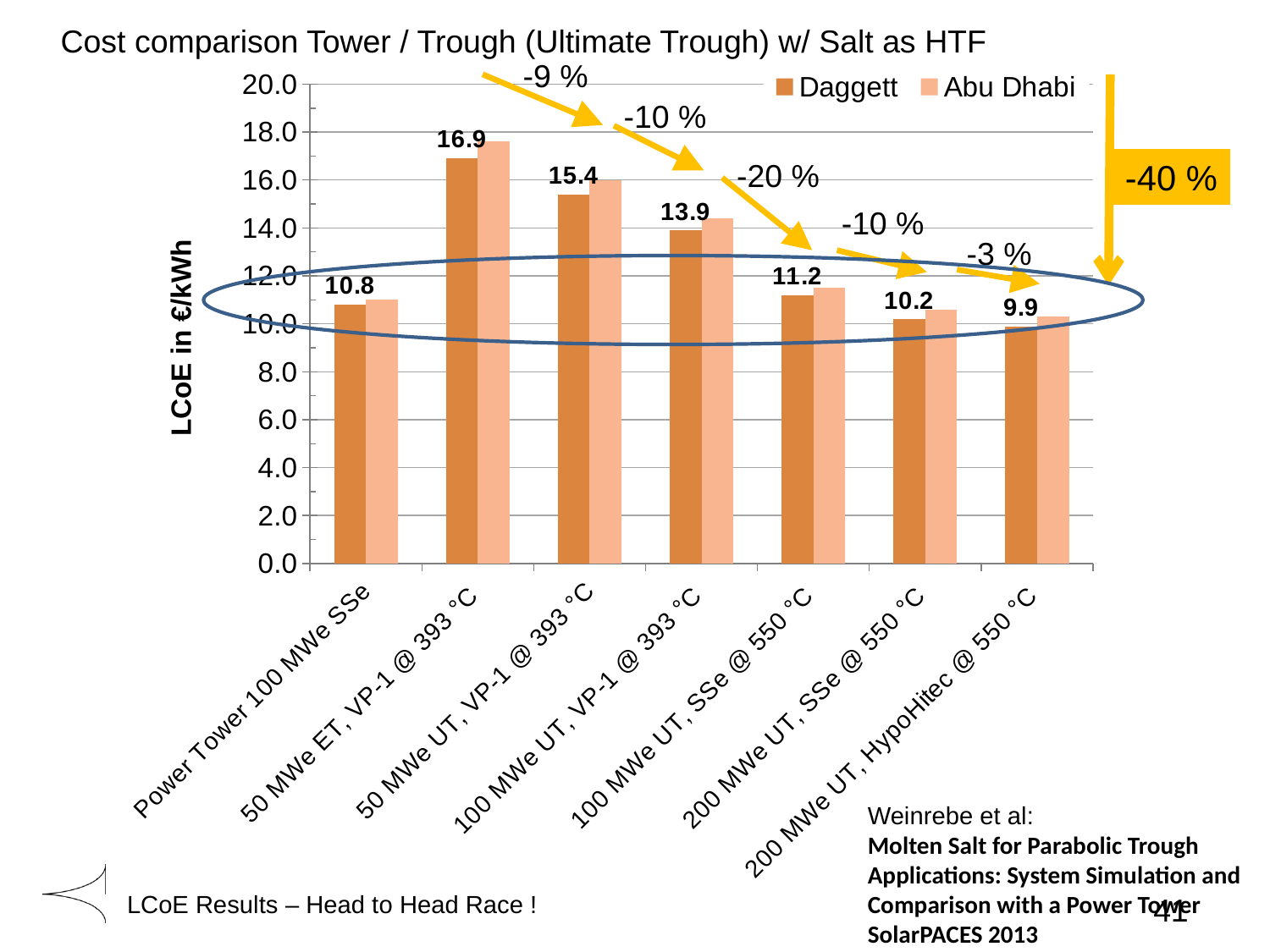
How many series does the legend list? 2 What is the Daggett LCoE value for the Power Tower 100 MWe SSe configuration? 10.8 What is the Daggett LCoE value for the 50 MWe ET, VP-1 @ 393 °C configuration? 16.9 Is the Abu Dhabi LCoE for 50 MWe ET, VP-1 @ 393 °C greater or less than 16.0? greater Is the Abu Dhabi LCoE for Power Tower 100 MWe SSe greater or less than 12.0? less What is the label of the vertical axis? LCoE in €/kWh Which has the larger Daggett LCoE: 50 MWe UT, VP-1 @ 393 °C or 100 MWe UT, SSe @ 550 °C? 50 MWe UT, VP-1 @ 393 °C What is the Daggett LCoE value for the 200 MWe UT, HypoHitec @ 550 °C configuration? 9.9 How many plant configurations are shown on the x axis? 7 Which configuration has the lowest Daggett LCoE? 200 MWe UT, HypoHitec @ 550 °C Which configuration has the highest Daggett LCoE? 50 MWe ET, VP-1 @ 393 °C What is the difference between the Daggett LCoE for 50 MWe ET, VP-1 @ 393 °C and for 200 MWe UT, HypoHitec @ 550 °C? 7.0